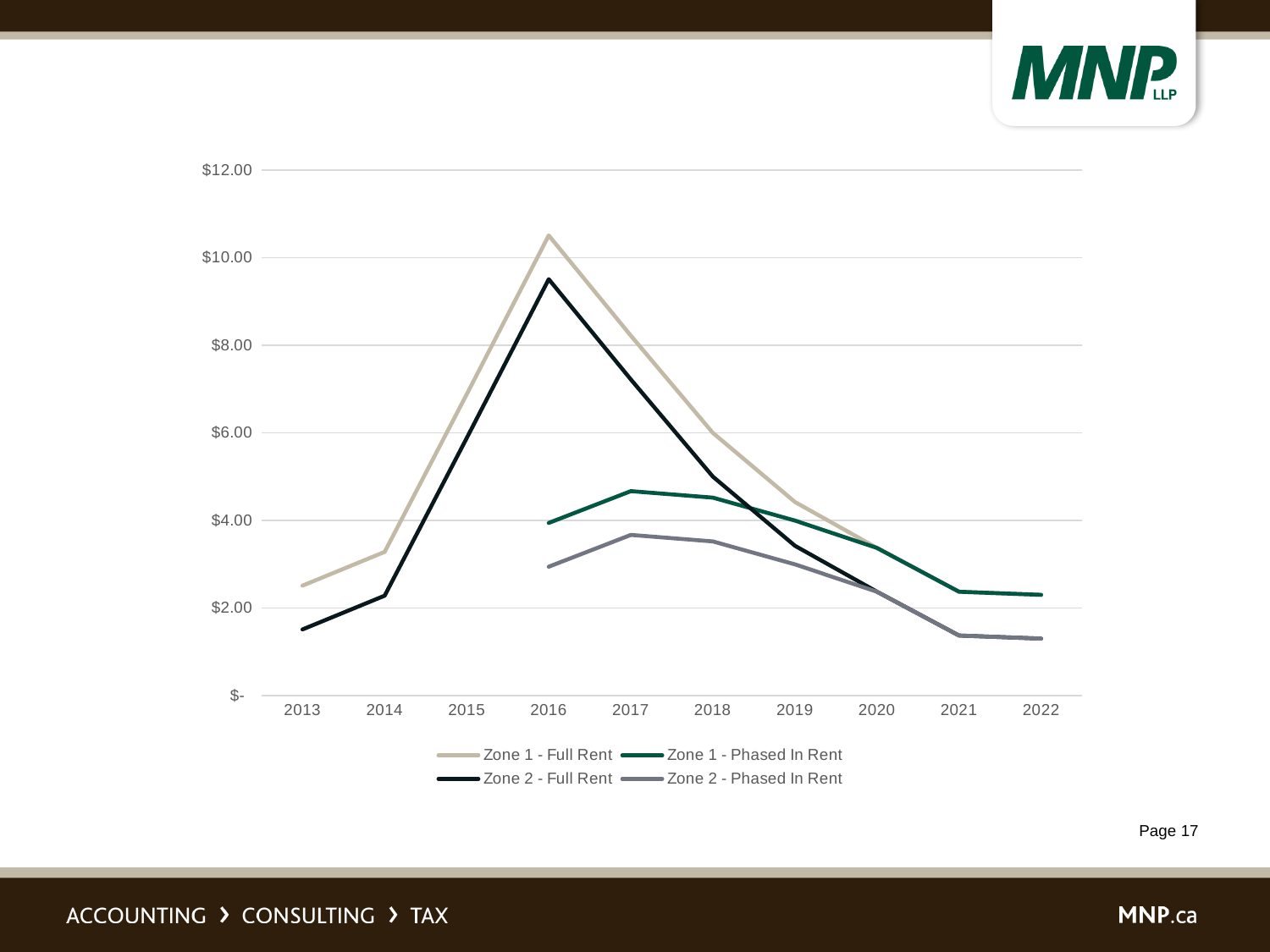
Is the value for Zone 2 - Full Rent in 2013 greater or less than $2.00? less Is the value for Zone 1 - Full Rent in 2016 greater or less than $10.00? greater How many years are shown on the x axis? 10 In 2016, which is larger: Zone 1 - Full Rent or Zone 2 - Full Rent? Zone 1 - Full Rent What kind of chart is shown on the slide? line chart Is the value for Zone 2 - Full Rent in 2016 greater or less than $10.00? less How many series does the legend list? 4 In which year do the Phased In Rent lines first appear on the chart? 2016 In which year does the Zone 1 - Full Rent line reach its highest value? 2016 In which year does the Zone 1 - Phased In Rent line reach its highest value? 2017 Does the Zone 1 - Full Rent line rise or fall from 2016 to 2022? fall